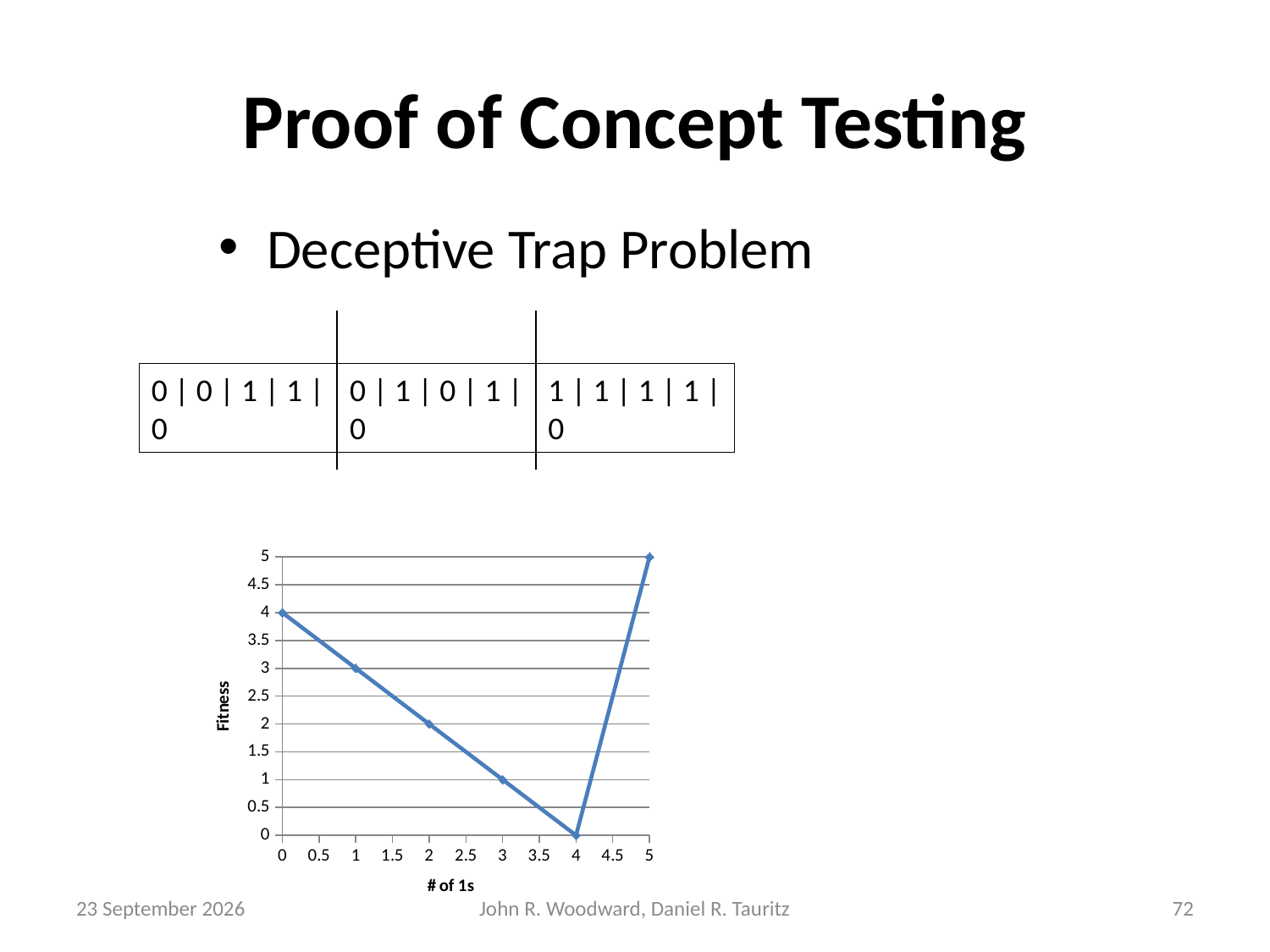
At which # of 1s is the fitness highest? 5 What is the fitness value when the # of 1s is 4? 0 Which has the higher fitness: 0 ones or 3 ones? 0 ones What is the fitness value when the # of 1s is 5? 5 How many data points are plotted on the chart? 6 What is the label of the vertical axis of the chart? Fitness What is the fitness value when the # of 1s is 2? 2 What kind of chart is shown on the slide? line chart What is the difference between the fitness at 5 ones and the fitness at 4 ones? 5 At which # of 1s is the fitness lowest? 4 What is the fitness value when the # of 1s is 0? 4 How does fitness change as the # of 1s increases from 0 to 4? It falls